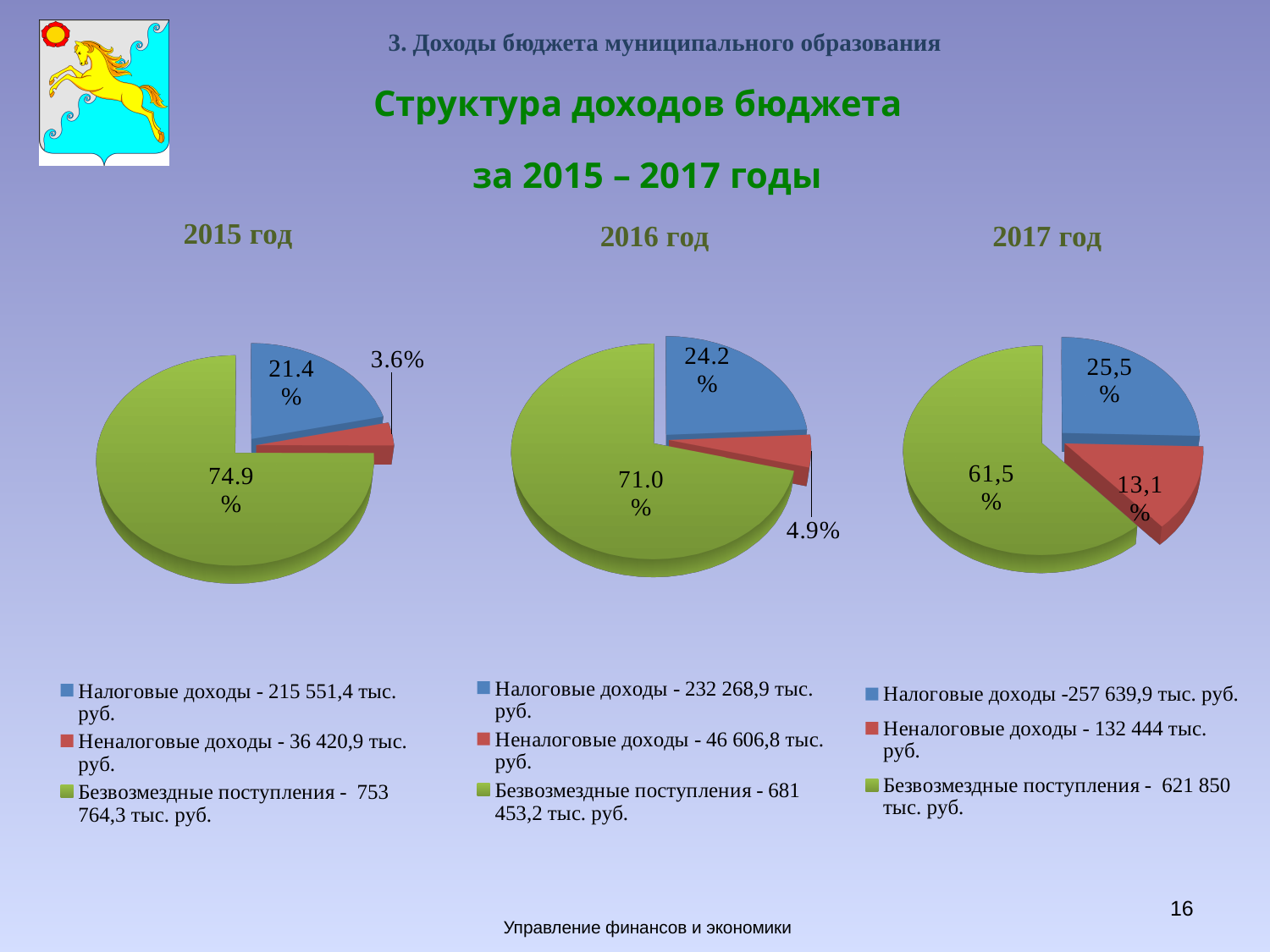
In the 2016 год pie chart, what share is shown for Налоговые доходы? 24.2% In the 2017 год pie chart, which category has the largest share? Безвозмездные поступления How many entries does the legend of the 2016 год chart list? 3 In the 2015 год pie chart, what share is shown for Безвозмездные поступления? 74.9% According to the legend of the 2017 год chart, what is the amount for Налоговые доходы? 257 639,9 тыс. руб. What type of chart is used for 2017 год? Pie chart How many slices does the 2015 год pie chart have? 3 In the 2017 год pie chart, which is larger: the share of Налоговые доходы or the share of Неналоговые доходы? Налоговые доходы In the 2015 год pie chart, what colour is the slice for Безвозмездные поступления? Green In the 2017 год pie chart, what share is shown for Неналоговые доходы? 13,1% In the 2016 год pie chart, what is the difference between the shares of Безвозмездные поступления and Налоговые доходы? 46.8% In the 2015 год pie chart, which category has the smallest share? Неналоговые доходы